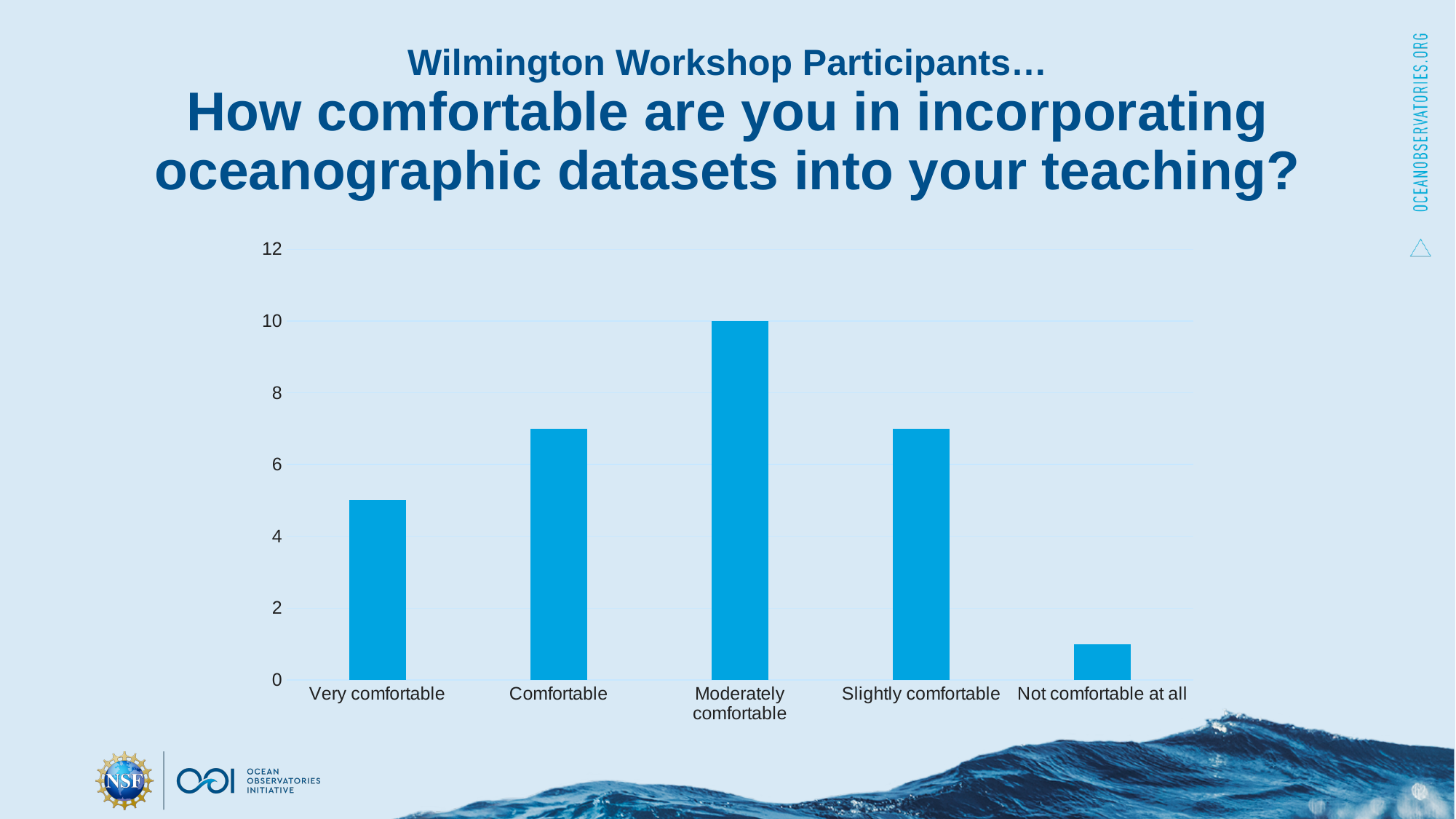
What type of chart is shown on the slide? bar chart Which category has the highest value? Moderately comfortable Which is larger, the value for Slightly comfortable or the value for Not comfortable at all? Slightly comfortable How many categories are shown on the x axis of the chart? 5 Which category has the lowest value? Not comfortable at all Which is larger, the value for Very comfortable or the value for Comfortable? Comfortable What is the highest value shown on the y axis of the chart? 12 Is the value for Not comfortable at all greater or less than 2? less Is the value for Slightly comfortable greater or less than 8? less What is the value for Moderately comfortable? 10 Is the value for Very comfortable greater or less than 6? less